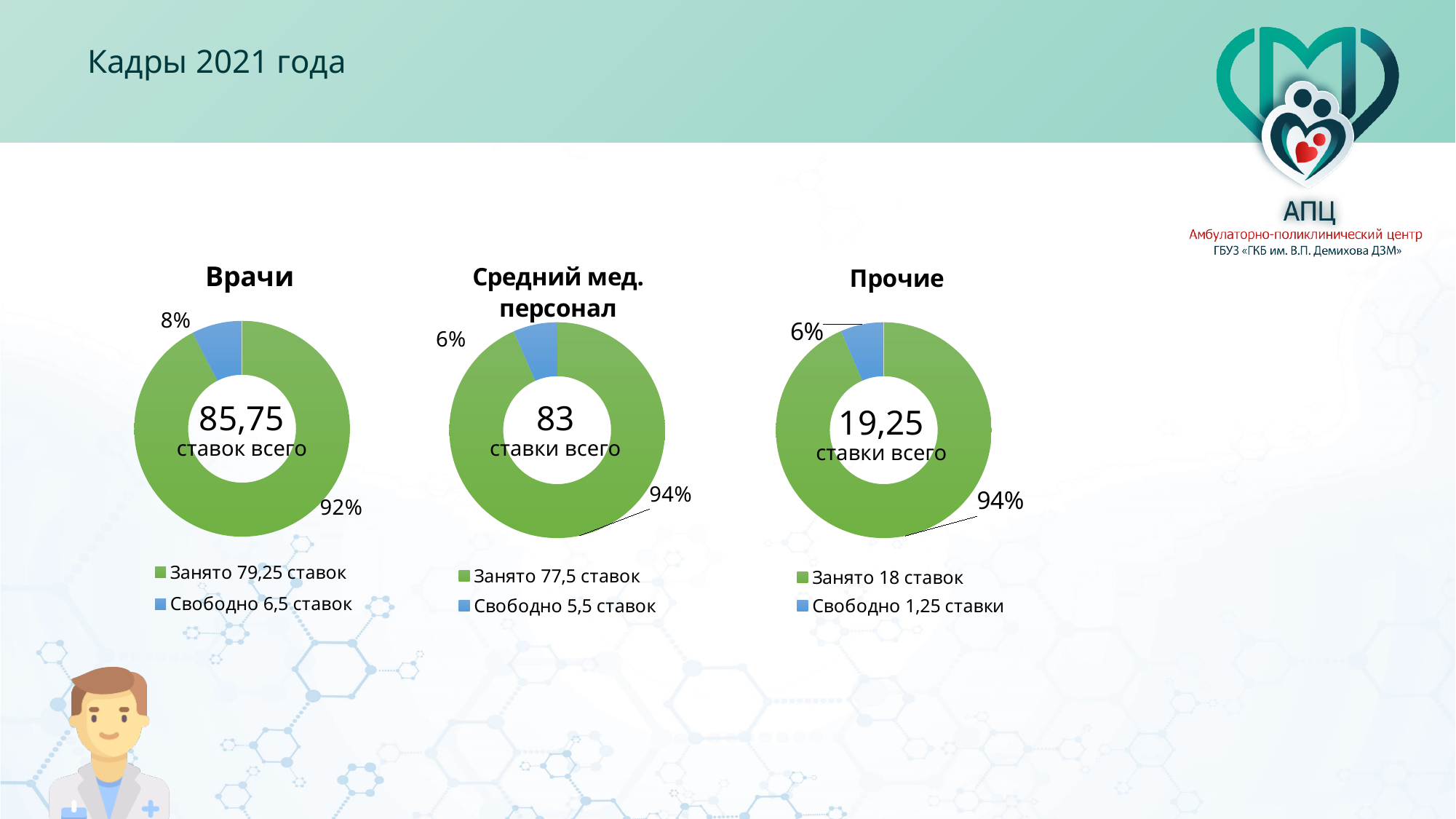
What total number of positions (ставки всего) is shown in the centre of the "Средний мед. персонал" chart? 83 What total number of positions (ставок всего) is shown in the centre of the "Врачи" chart? 85,75 According to the legend of the "Средний мед. персонал" chart, how many positions are occupied (Занято)? 77,5 ставок In the "Врачи" chart, what share of positions is shown as free (Свободно)? 8% In the "Врачи" chart, what share of positions is shown as occupied (Занято)? 92% How many entries does the legend of the "Прочие" chart list? 2 In the "Прочие" chart, what share is shown for the occupied (Занято) slice? 94% What type of chart is used for "Врачи", "Средний мед. персонал" and "Прочие"? Pie (donut) chart What total number of positions (ставки всего) is shown in the centre of the "Прочие" chart? 19,25 In the "Врачи" chart, which slice is larger: Занято or Свободно? Занято According to the legend of the "Прочие" chart, how many positions are free (Свободно)? 1,25 ставки